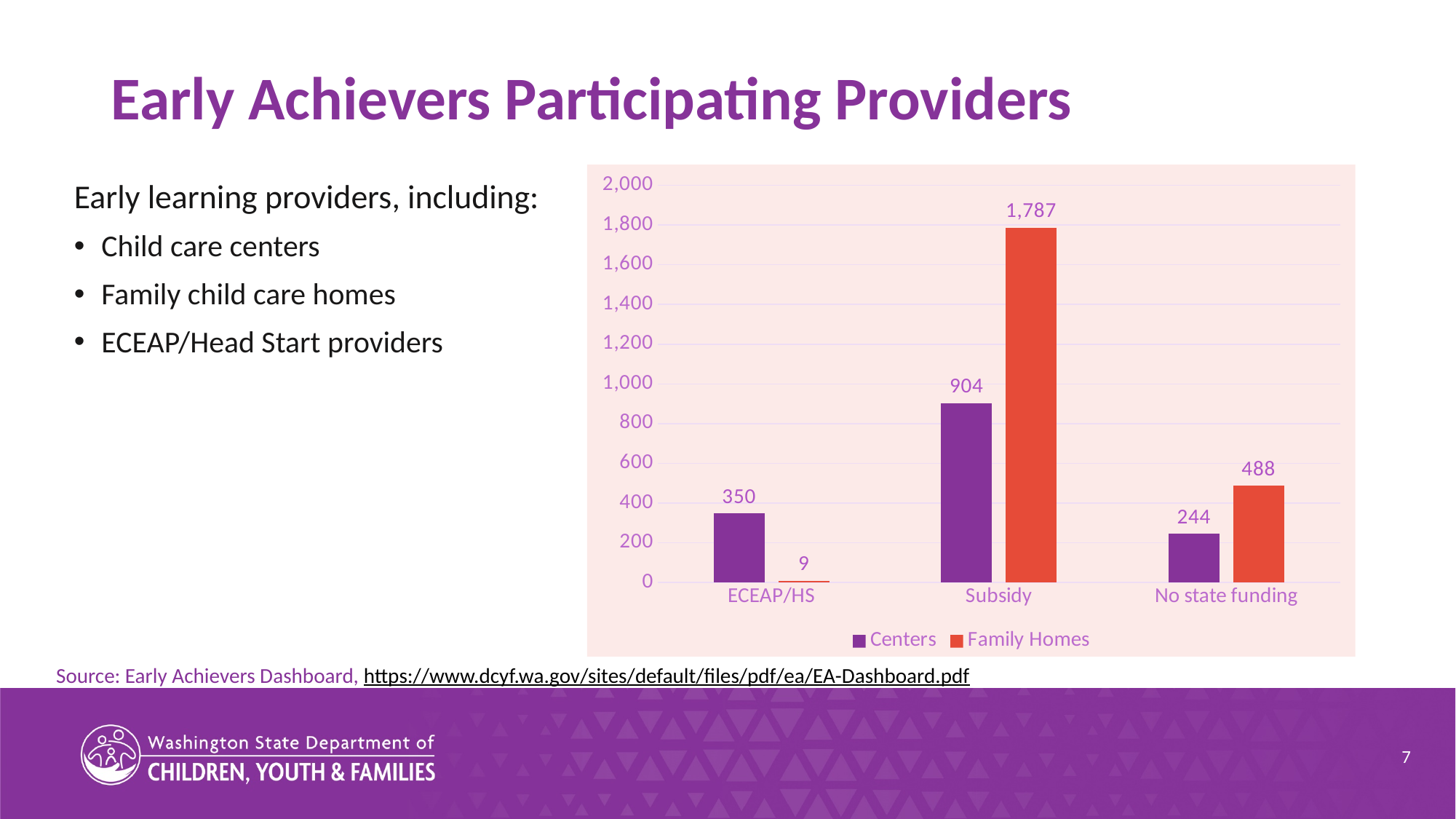
What is the difference between Family Homes and Centers in the Subsidy category? 883 Which is larger in the No state funding category, Centers or Family Homes? Family Homes What is the value for Family Homes in the ECEAP/HS category? 9 Which category has the highest value for Family Homes? Subsidy What is the value for Centers in the ECEAP/HS category? 350 Which category has the lowest value for Centers? No state funding What kind of chart is shown on the slide? Bar chart How many series does the legend list? 2 What is the value for Family Homes in the No state funding category? 488 How many categories are shown on the x axis? 3 Which colour represents the Family Homes series? Red What is the value for Centers in the Subsidy category? 904